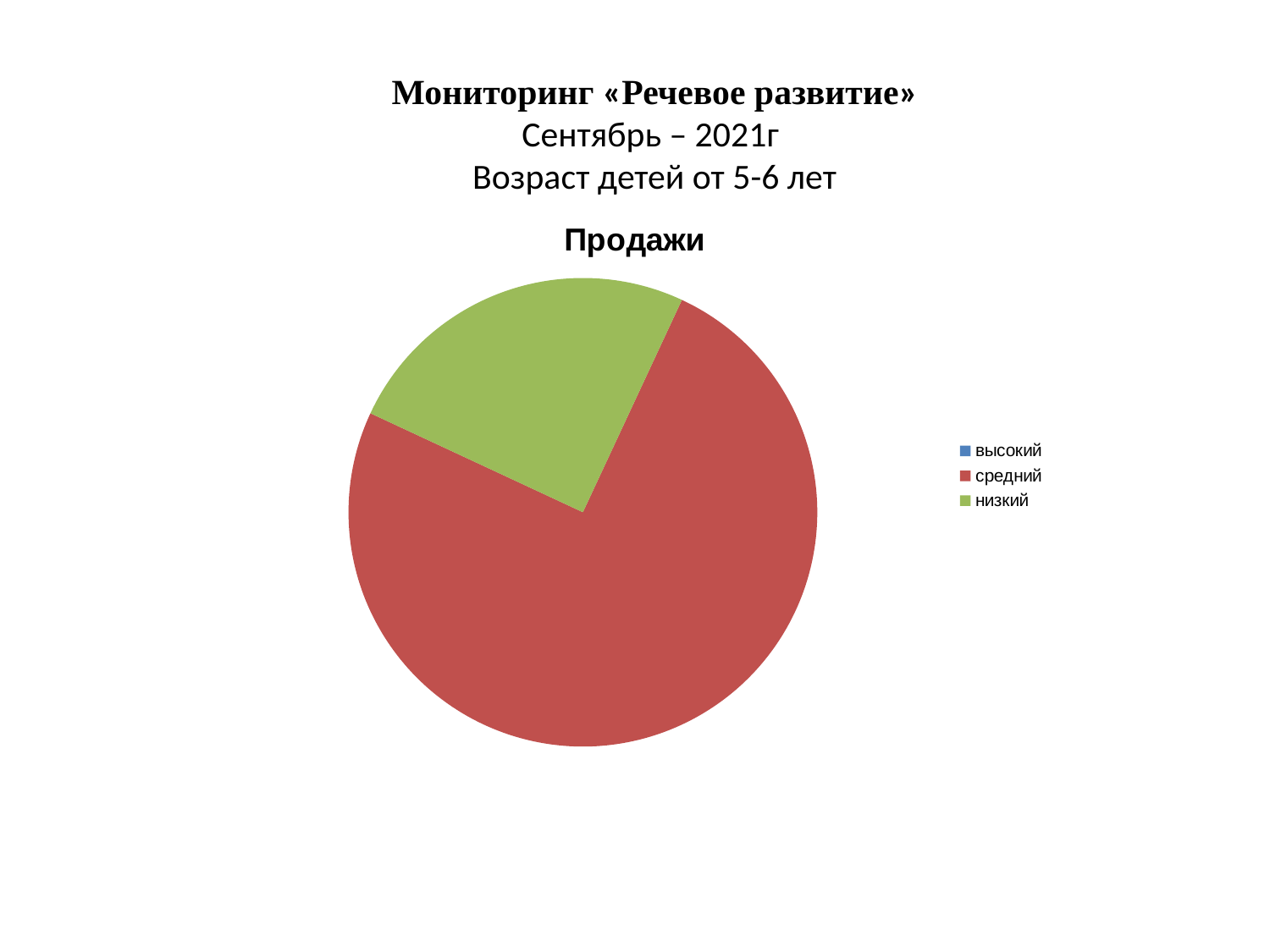
What is the title of the chart? Продажи Which legend category has no visible slice in the pie? высокий Which is larger, the slice for средний or the slice for низкий? средний What kind of chart is shown on the slide? pie chart Which of the two visible slices, средний or низкий, is smaller? низкий Which category has the largest slice of the pie? средний Does the slice for средний take up more or less than half of the pie? more How many categories does the chart legend list? 3